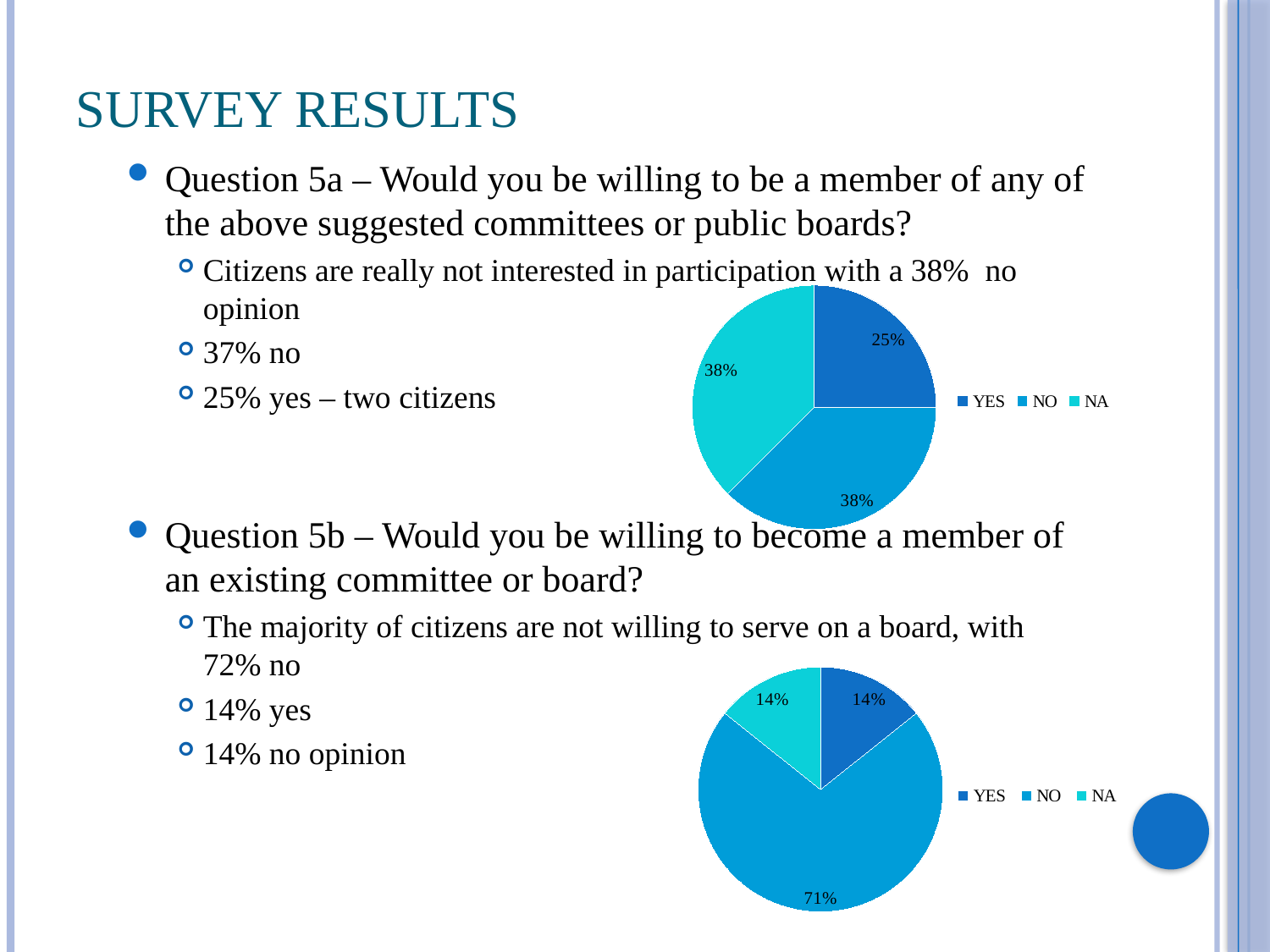
In the lower pie chart, what percentage is shown for YES? 14% What kind of chart is the upper chart on the slide? pie chart In the upper pie chart, which category has the smallest slice? YES In the upper pie chart, what percentage is shown for NA? 38% In the lower pie chart, what is the difference between the NO and YES percentages? 57% In the upper pie chart, what percentage is shown for NO? 38% In the lower pie chart, what percentage is shown for NO? 71% In the upper pie chart, what percentage is shown for YES? 25% In the upper pie chart, how many slices are there? 3 How many entries does the legend of the lower pie chart list? 3 In the lower pie chart, which is larger, the NO slice or the NA slice? NO In the lower pie chart, which category has the largest slice? NO